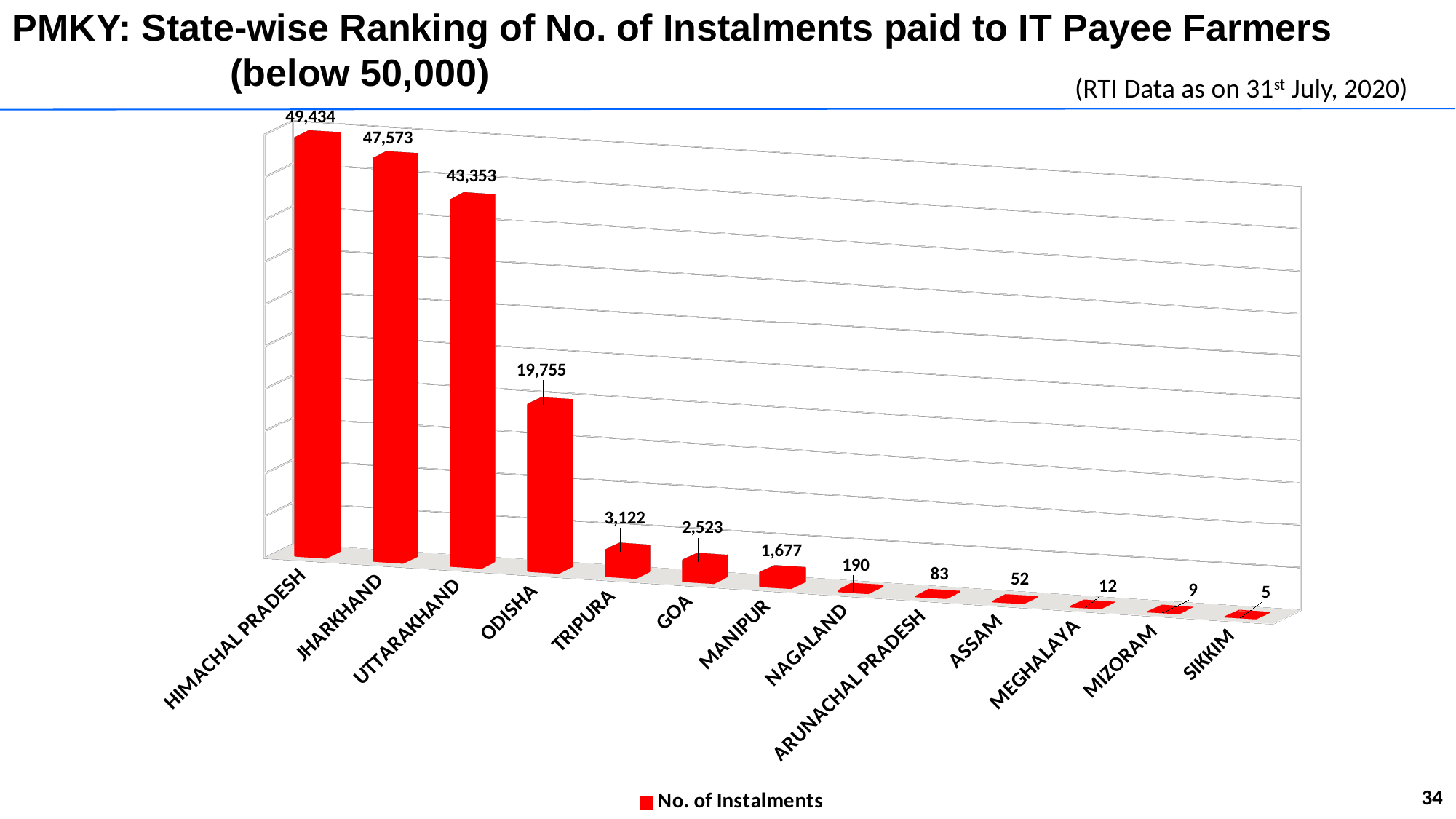
Which has more instalments, Tripura or Manipur? Tripura What is the number of instalments for Odisha? 19,755 What is the number of instalments for Himachal Pradesh? 49,434 Which state has the lowest number of instalments? Sikkim What is the legend entry for the series in the chart? No. of Instalments What is the difference in number of instalments between Jharkhand and Uttarakhand? 4,220 What is the number of instalments for Goa? 2,523 How many states are shown in the chart? 13 What kind of chart is shown on the slide? Bar chart Which state has the highest number of instalments? Himachal Pradesh How many series does the legend list? 1 What is the number of instalments for Arunachal Pradesh? 83